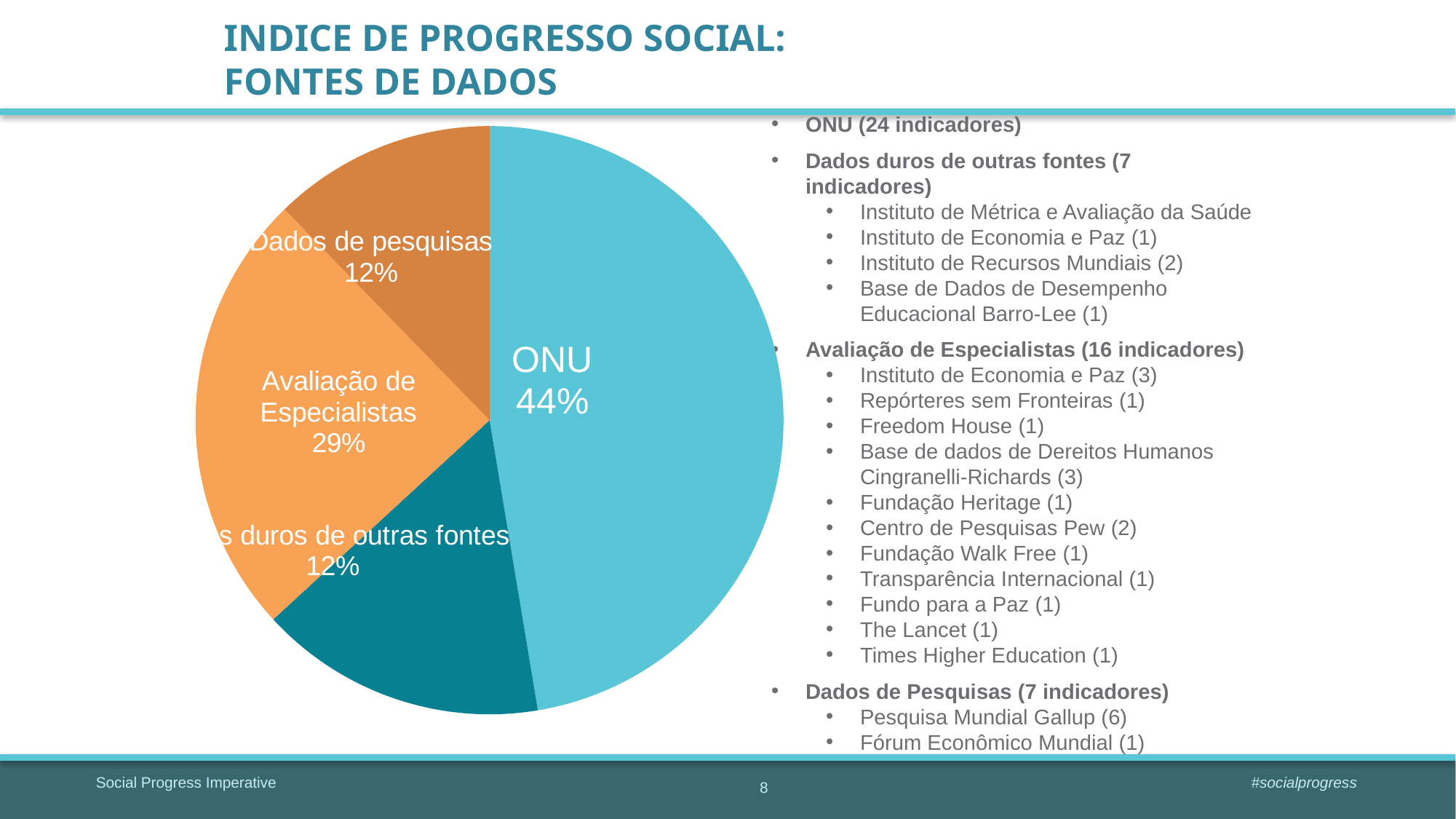
Which is larger, the ONU slice or the Avaliação de Especialistas slice? ONU What percentage is shown for the Dados duros de outras fontes slice? 12% What is the combined share of the Dados de pesquisas and Dados duros de outras fontes slices? 24% Do the Dados de pesquisas and Dados duros de outras fontes slices have the same percentage? Yes, both 12% What is the difference in percentage points between the ONU slice and the Avaliação de Especialistas slice? 15 percentage points What percentage is shown for Dados de pesquisas? 12% What kind of chart is shown on the slide? Pie chart What colour is the ONU slice of the pie chart? Light blue What share of the pie does the ONU slice represent? 44% Which slice of the pie is the largest? ONU What percentage is shown for Avaliação de Especialistas? 29% How many slices does the pie chart have? 4